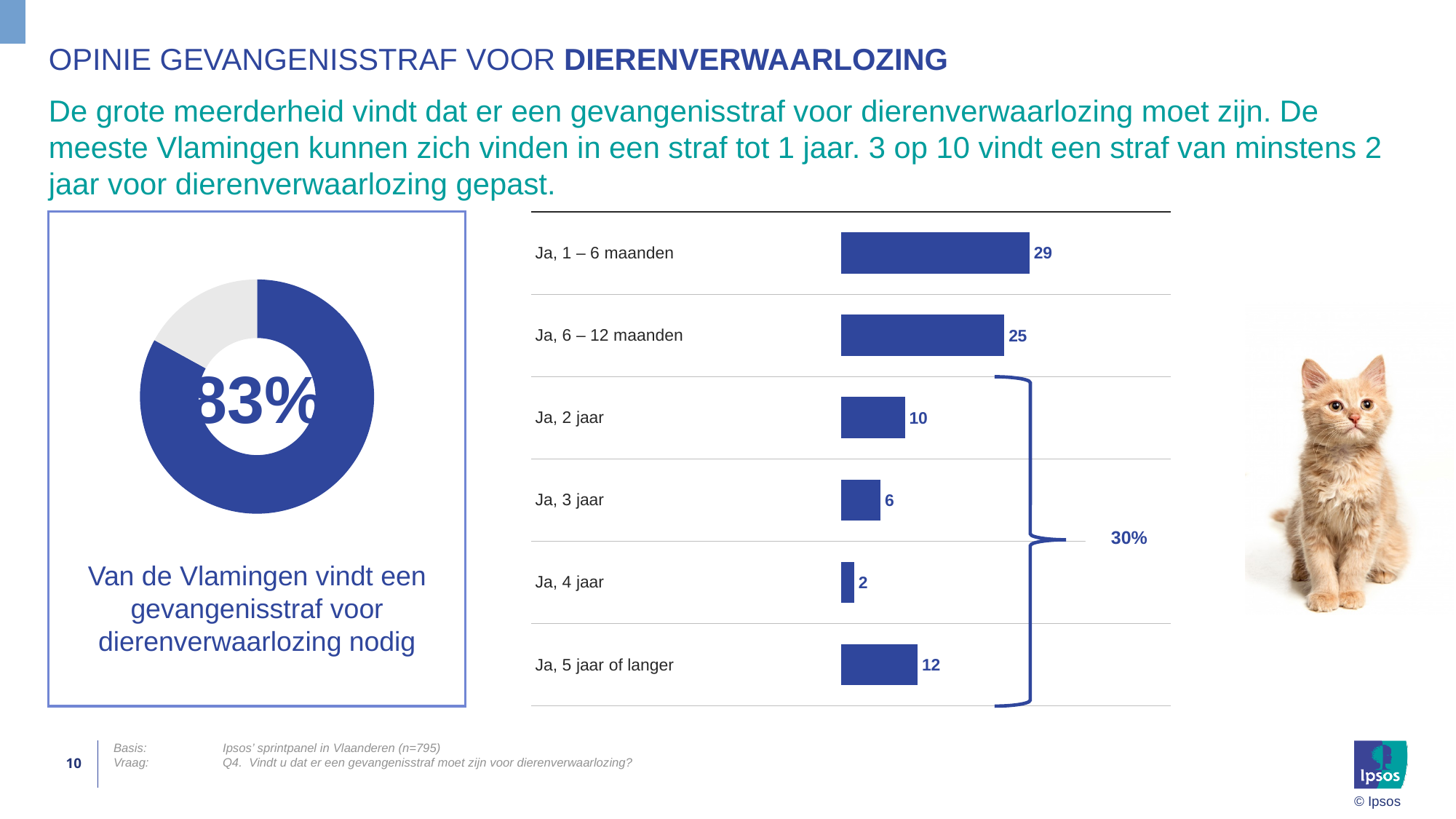
In the bar chart on the right, what is the value for "Ja, 1 – 6 maanden"? 29 In the bar chart on the right, what is the difference between the values for "Ja, 1 – 6 maanden" and "Ja, 6 – 12 maanden"? 4 In the bar chart on the right, what percentage does the bracket grouping the categories from "Ja, 2 jaar" to "Ja, 5 jaar of langer" indicate? 30% How many categories does the bar chart on the right show? 6 In the bar chart on the right, which category has the highest value? Ja, 1 – 6 maanden What kind of chart is shown on the left side of the slide? Donut chart In the bar chart on the right, what is the value for "Ja, 3 jaar"? 6 What kind of chart is shown on the right side of the slide? Bar chart What percentage is shown in the centre of the donut chart on the left? 83% In the bar chart on the right, what is the value for "Ja, 5 jaar of langer"? 12 In the bar chart on the right, which category has the lowest value? Ja, 4 jaar In the bar chart on the right, which is larger: the value for "Ja, 2 jaar" or "Ja, 5 jaar of langer"? Ja, 5 jaar of langer